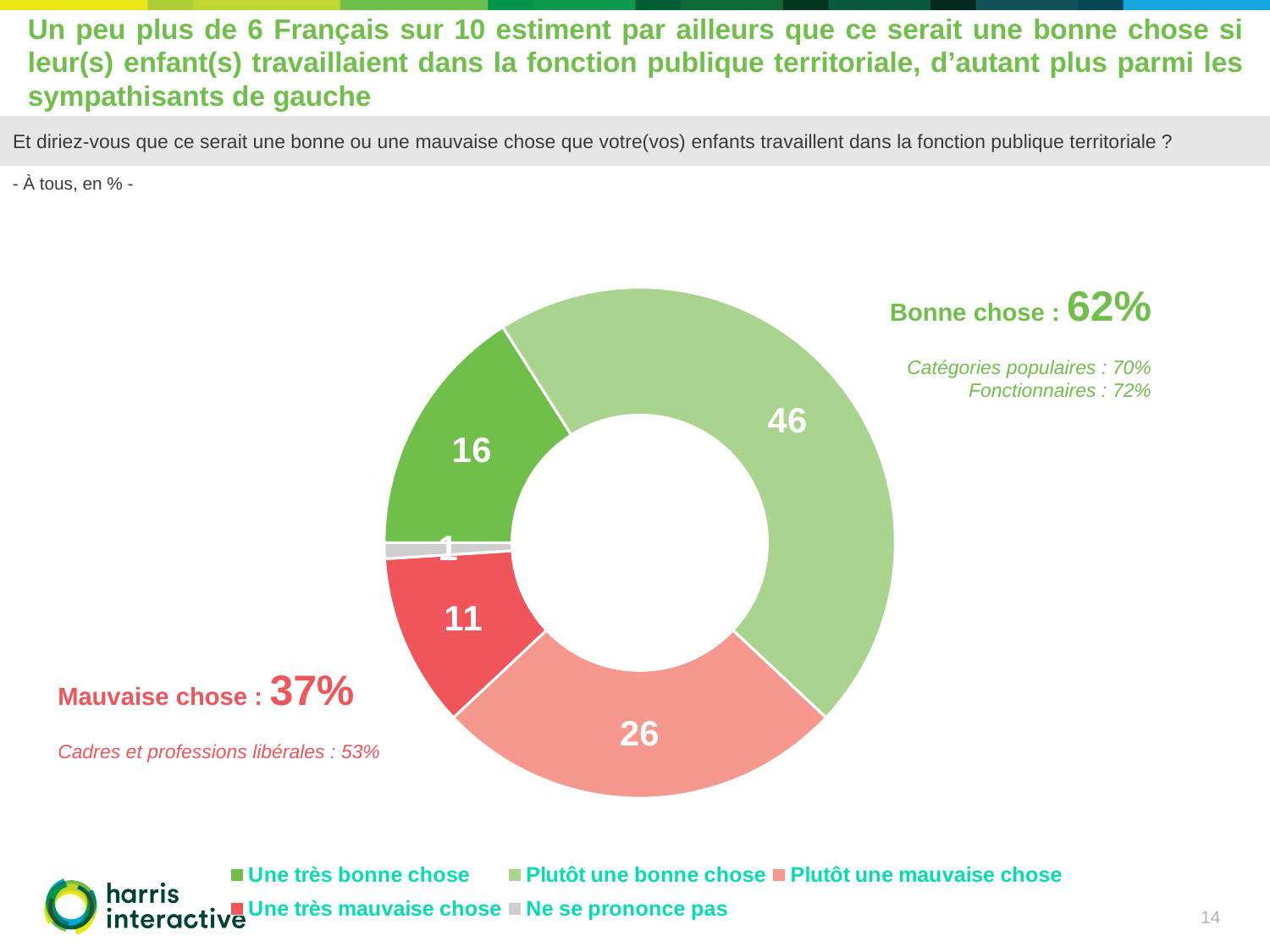
What is the difference between the values for "Plutôt une bonne chose" and "Plutôt une mauvaise chose"? 20 What is the value for "Ne se prononce pas"? 1 What kind of chart is shown on the slide? Pie chart (donut) Which is larger, the value for "Une très bonne chose" or the value for "Une très mauvaise chose"? Une très bonne chose Which category has the largest slice? Plutôt une bonne chose What is the value for "Une très bonne chose"? 16 How many categories does the legend list? 5 What is the value for "Plutôt une bonne chose"? 46 What total percentage is given for "Bonne chose" next to the chart? 62% What is the value for "Une très mauvaise chose"? 11 Which category has the smallest slice? Ne se prononce pas What is the value for "Plutôt une mauvaise chose"? 26